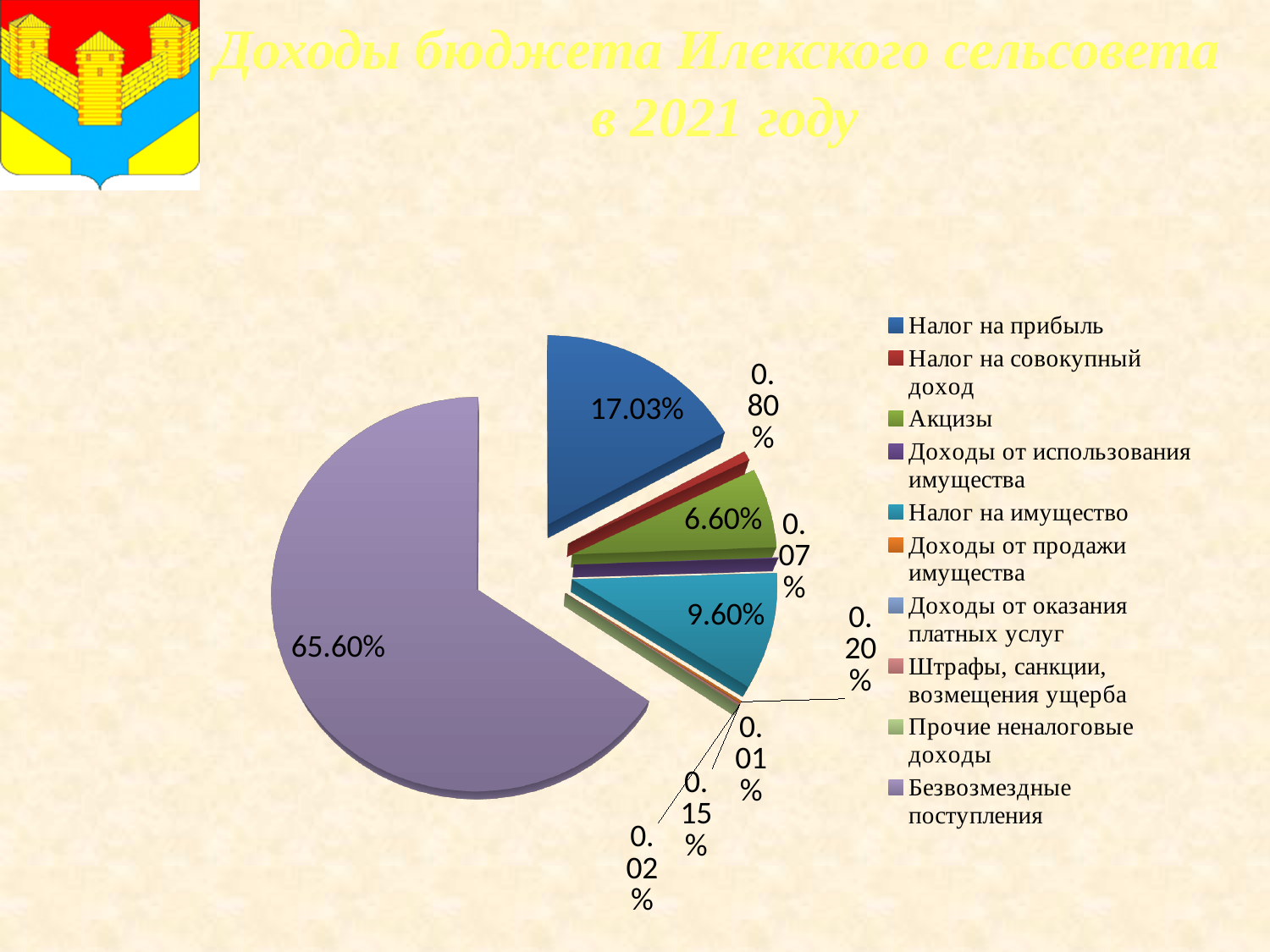
What share of the pie does Безвозмездные поступления have? 65.60% What kind of chart is shown on the slide? Pie chart How many entries does the legend list? 10 What is the title of the slide? Доходы бюджета Илекского сельсовета в 2021 году What is the value shown for Налог на имущество? 9.60% What is the value shown for Налог на совокупный доход? 0.80% What is the value shown for Налог на прибыль? 17.03% What is the value shown for Акцизы? 6.60% What is the difference between the shares of Налог на прибыль and Налог на имущество? 7.43% What is the difference between the shares of Безвозмездные поступления and Налог на прибыль? 48.57% Which category has the largest slice of the pie? Безвозмездные поступления Which is larger, Налог на имущество or Акцизы? Налог на имущество